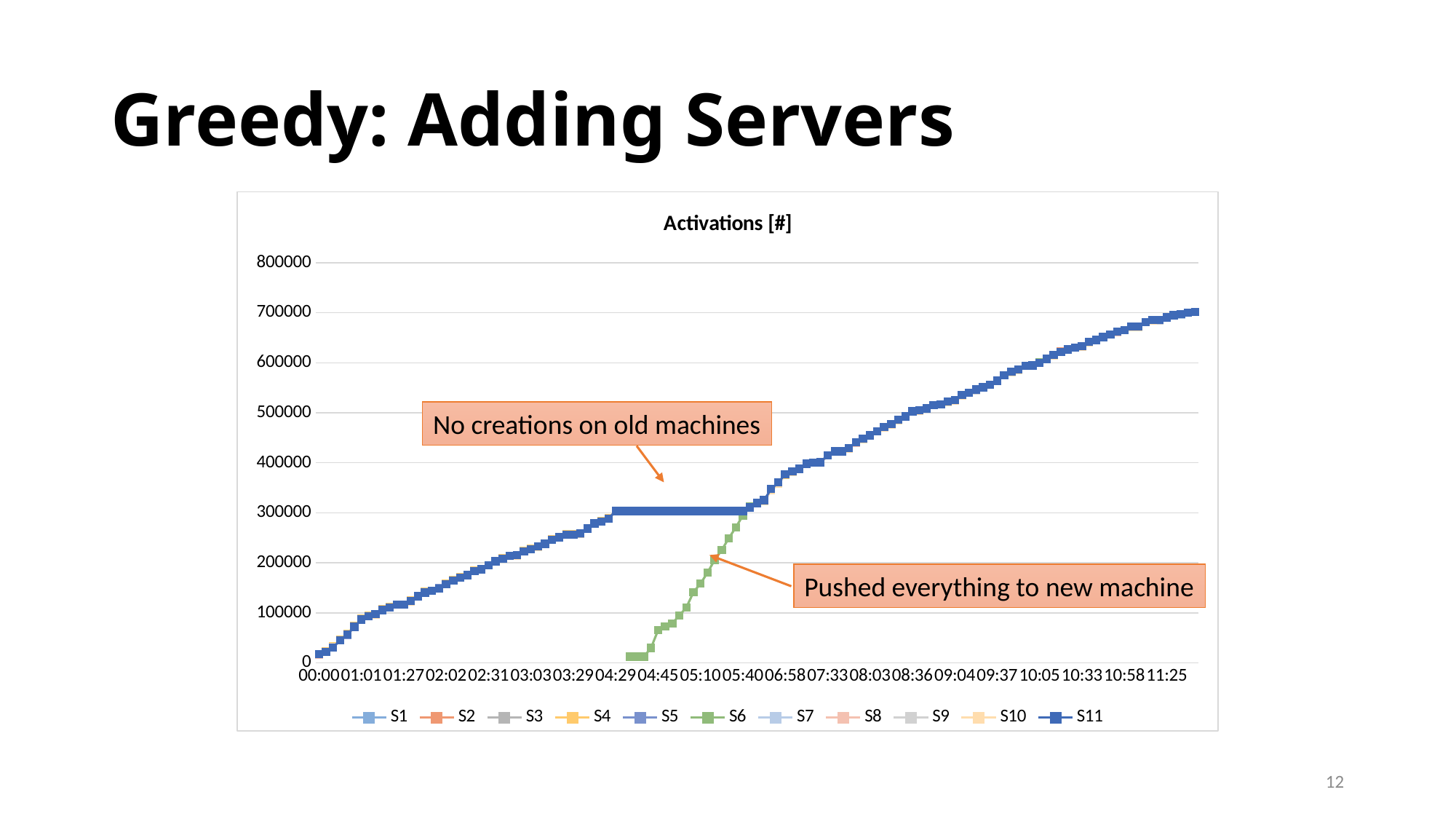
Is the value of the green S6 line at 05:10 greater or less than 300000? less What is the highest value shown on the y axis? 800000 Does the green S6 line rise or fall between 04:29 and 05:40? rises At 04:45, which is higher: the blue line or the green S6 line? the blue line What kind of chart is shown on the slide? line chart What is the title of the chart? Activations [#] How many series does the legend list? 11 Is the value of the blue line at 11:25 greater or less than 600000? greater What colour is the S6 series line? green Does the blue line rise or fall from 00:00 to 11:25? rises Is the value of the blue line at 00:00 greater or less than 100000? less